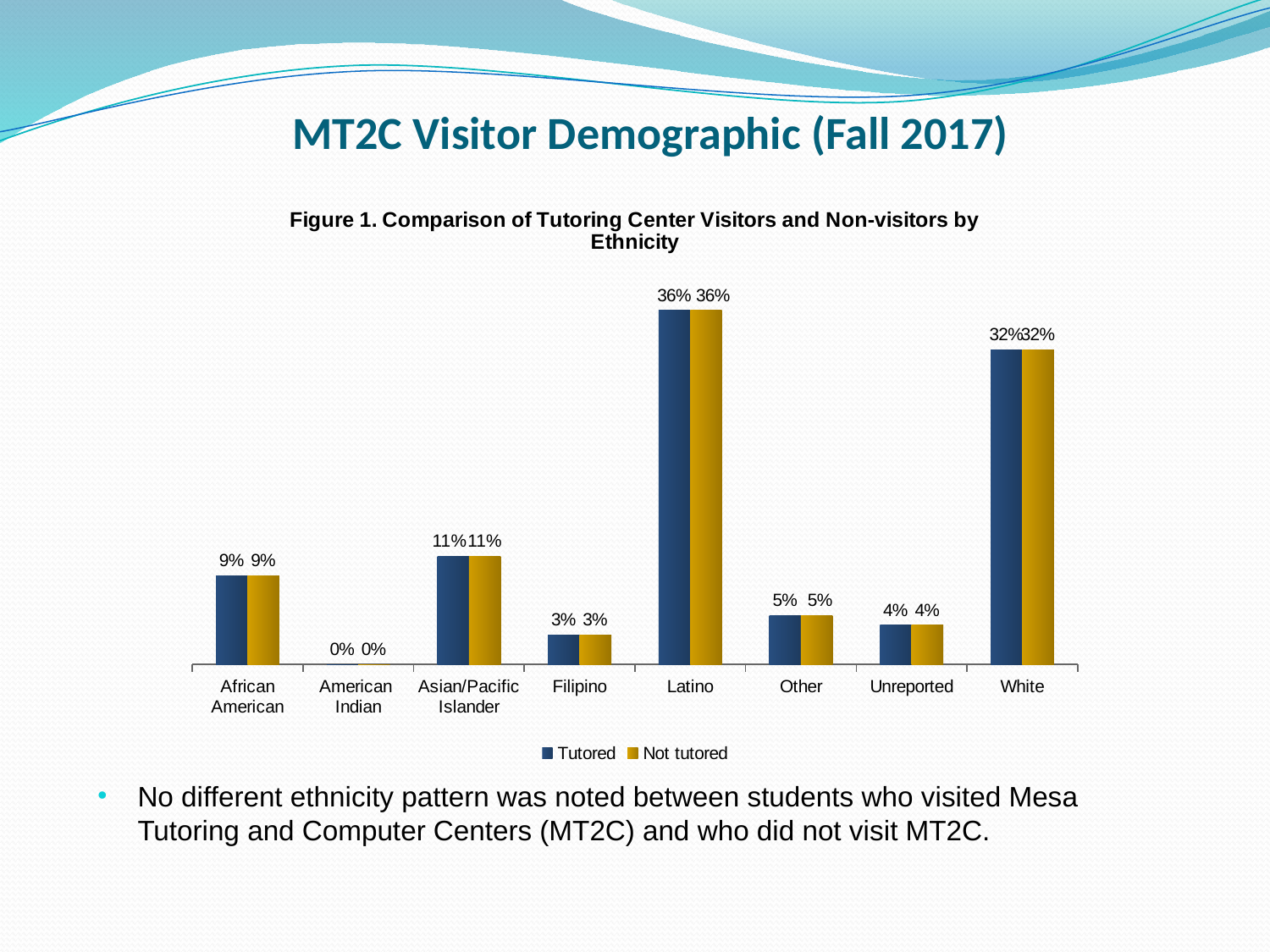
How many ethnicity categories are shown on the x axis? 8 What is the Tutored value for Latino? 36% How many series does the legend list? 2 Which ethnicity has the lowest Not tutored value? American Indian Which ethnicity has the highest Tutored value? Latino What is the difference between the Tutored values for Latino and White? 4% What is the Not tutored value for White? 32% What kind of chart is shown? Bar chart What is the Not tutored value for Filipino? 3% Which is larger, the Tutored value for African American or the Tutored value for Other? African American What is the title of the chart? Figure 1. Comparison of Tutoring Center Visitors and Non-visitors by Ethnicity What is the Tutored value for Asian/Pacific Islander? 11%